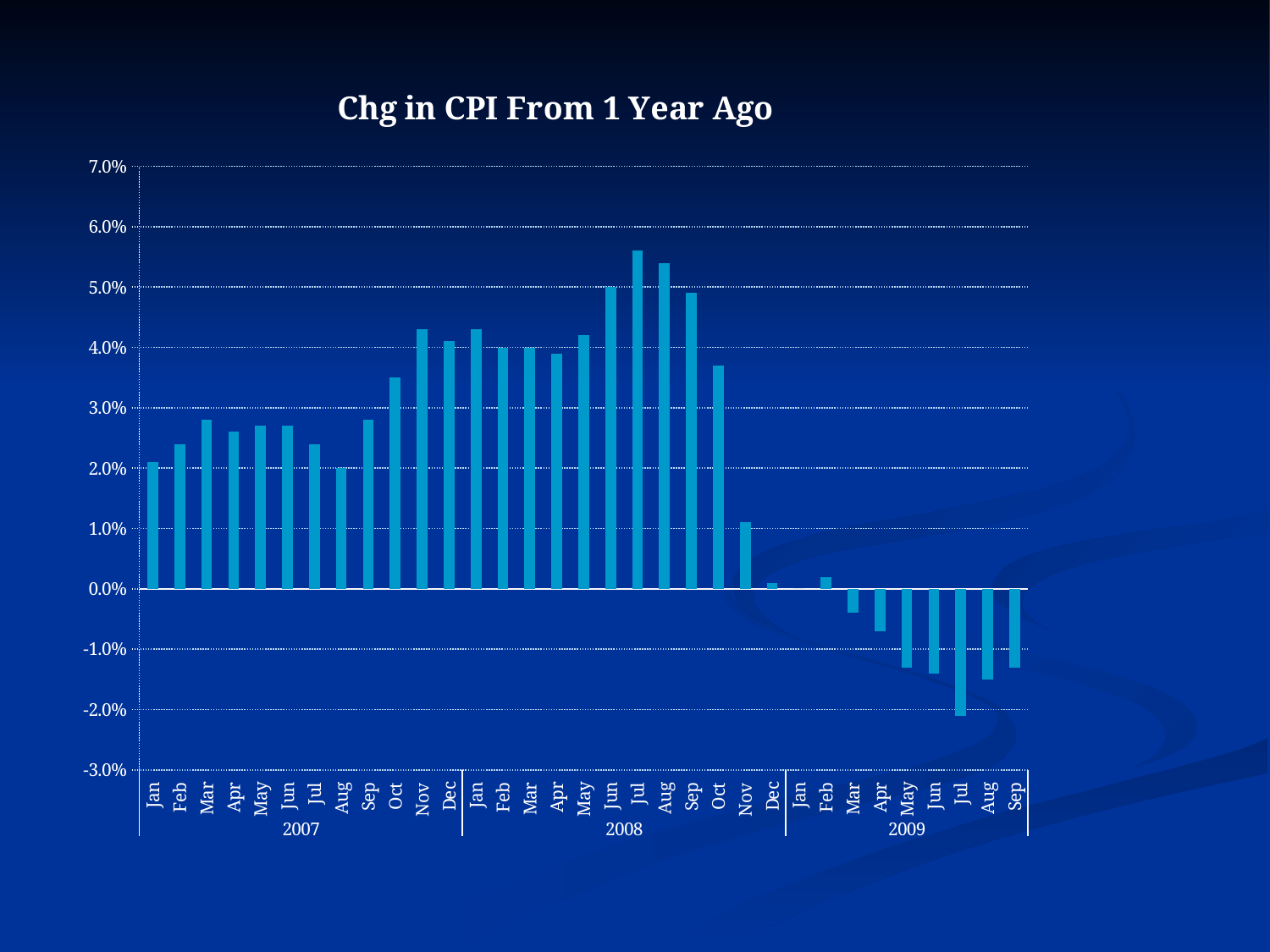
Which is larger, the value for Mar 2007 or the value for Aug 2007? Mar 2007 Do the values rise or fall from Jan 2009 to Jul 2009? fall Which month has the highest change in CPI from 1 year ago? Jul 2008 Which is larger, the value for Jul 2008 or the value for Oct 2008? Jul 2008 Which month has the lowest change in CPI from 1 year ago? Jul 2009 Is the value for Jul 2008 greater or less than 5.0%? greater What kind of chart is shown on the slide? bar chart Is the value for Oct 2007 greater or less than 3.0%? greater How many monthly bars are plotted on the chart? 33 What is the title of the chart? Chg in CPI From 1 Year Ago Is the value for Nov 2008 greater or less than 2.0%? less